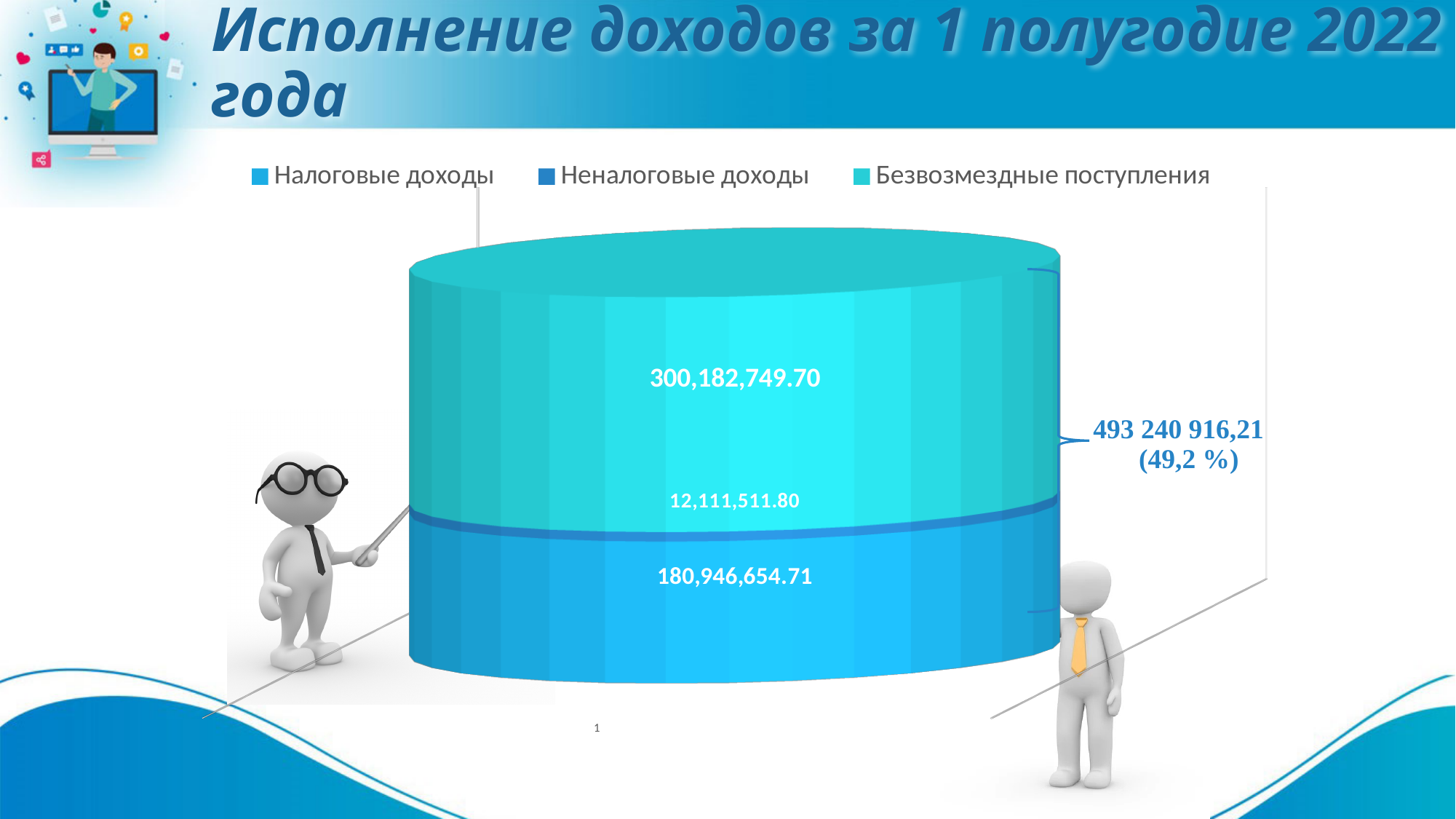
What is the value shown for Неналоговые доходы? 12,111,511.80 Which is larger, Налоговые доходы or Безвозмездные поступления? Безвозмездные поступления How many series does the legend list? 3 What kind of chart is shown on the slide? Stacked bar chart What percentage is shown in parentheses next to the total of the bar? 49,2 % What is the value shown for Безвозмездные поступления? 300,182,749.70 What is the difference between Безвозмездные поступления and Налоговые доходы? 119,236,094.99 What is the value shown for Налоговые доходы? 180,946,654.71 Which series has the largest value in the stacked bar? Безвозмездные поступления What is the total of the stacked bar, as labelled on the slide? 493 240 916,21 Which series has the smallest value in the stacked bar? Неналоговые доходы What is the difference between Налоговые доходы and Неналоговые доходы? 168,835,142.91